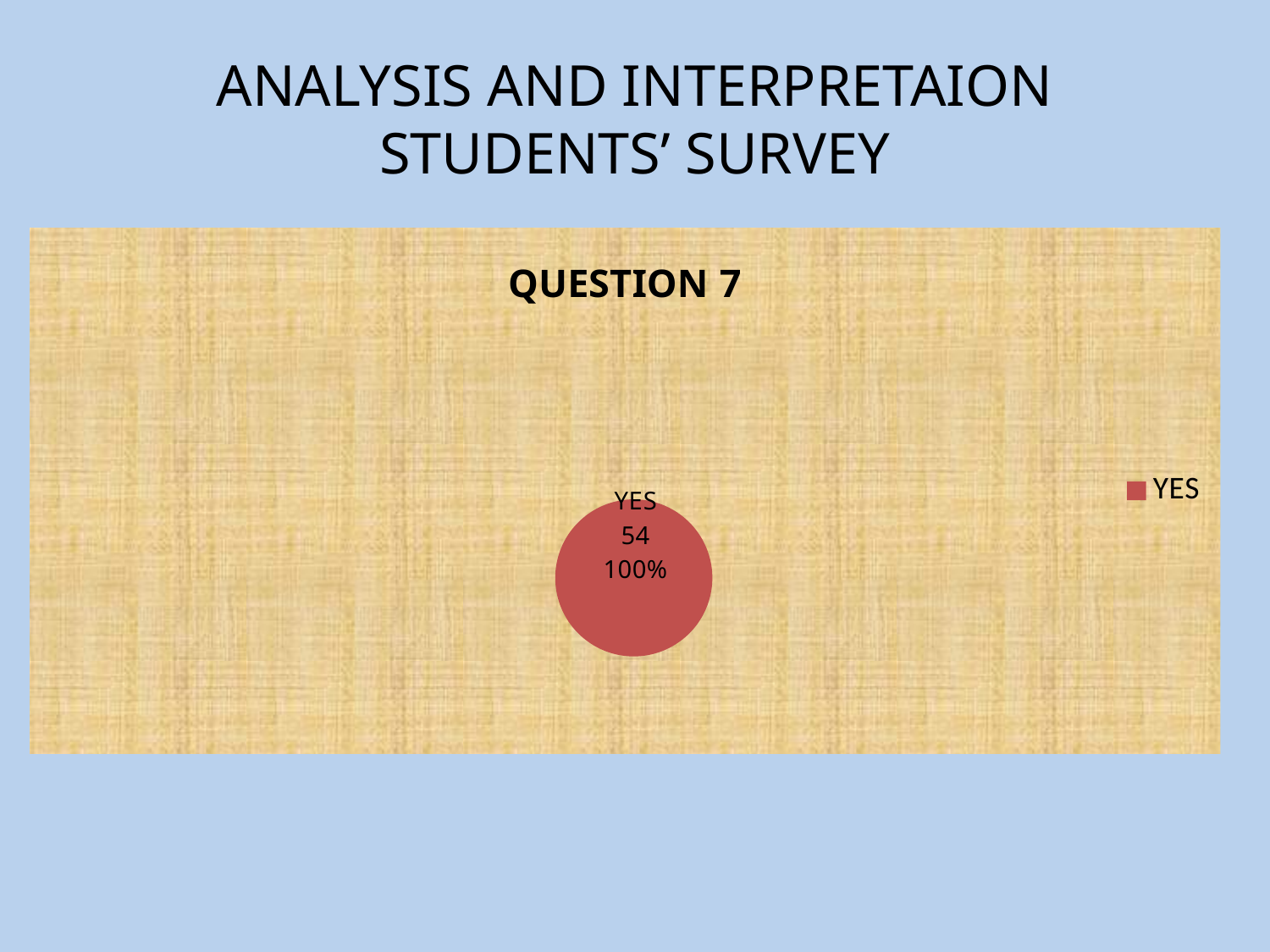
What share of the pie does YES represent? 100% What is the title of the chart? QUESTION 7 What kind of chart is shown on the slide? pie chart How many entries does the legend list? 1 What label appears in the legend? YES How many slices does the pie chart have? 1 What is the value shown for YES? 54